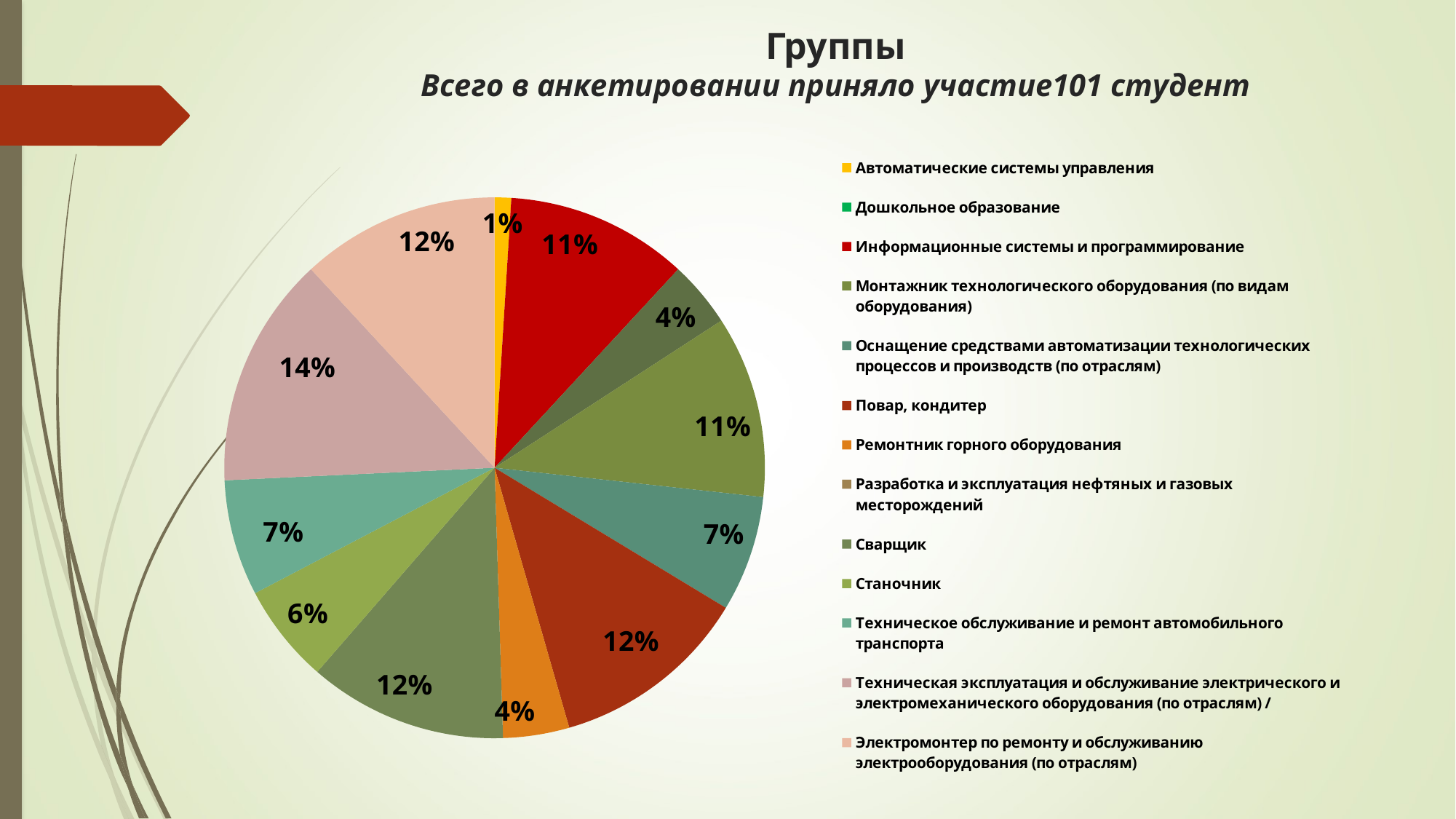
What kind of chart is shown on the slide? Pie chart How many percentage points larger is the share of "Повар, кондитер" than the share of "Ремонтник горного оборудования"? 8 What share of the pie does "Информационные системы и программирование" have? 11% Which group has the smallest labelled slice of the pie? Автоматические системы управления What share of the pie does "Повар, кондитер" have? 12% Which has the larger share: "Станочник" or "Оснащение средствами автоматизации технологических процессов и производств (по отраслям)"? Оснащение средствами автоматизации технологических процессов и производств (по отраслям) What share of the pie does "Электромонтер по ремонту и обслуживанию электрооборудования (по отраслям)" have? 12% What share of the pie does "Техническая эксплуатация и обслуживание электрического и электромеханического оборудования (по отраслям)" have? 14% What share of the pie does "Ремонтник горного оборудования" have? 4% How many entries does the legend list? 13 Which group has the largest slice of the pie? Техническая эксплуатация и обслуживание электрического и электромеханического оборудования (по отраслям) What share of the pie does "Автоматические системы управления" have? 1%